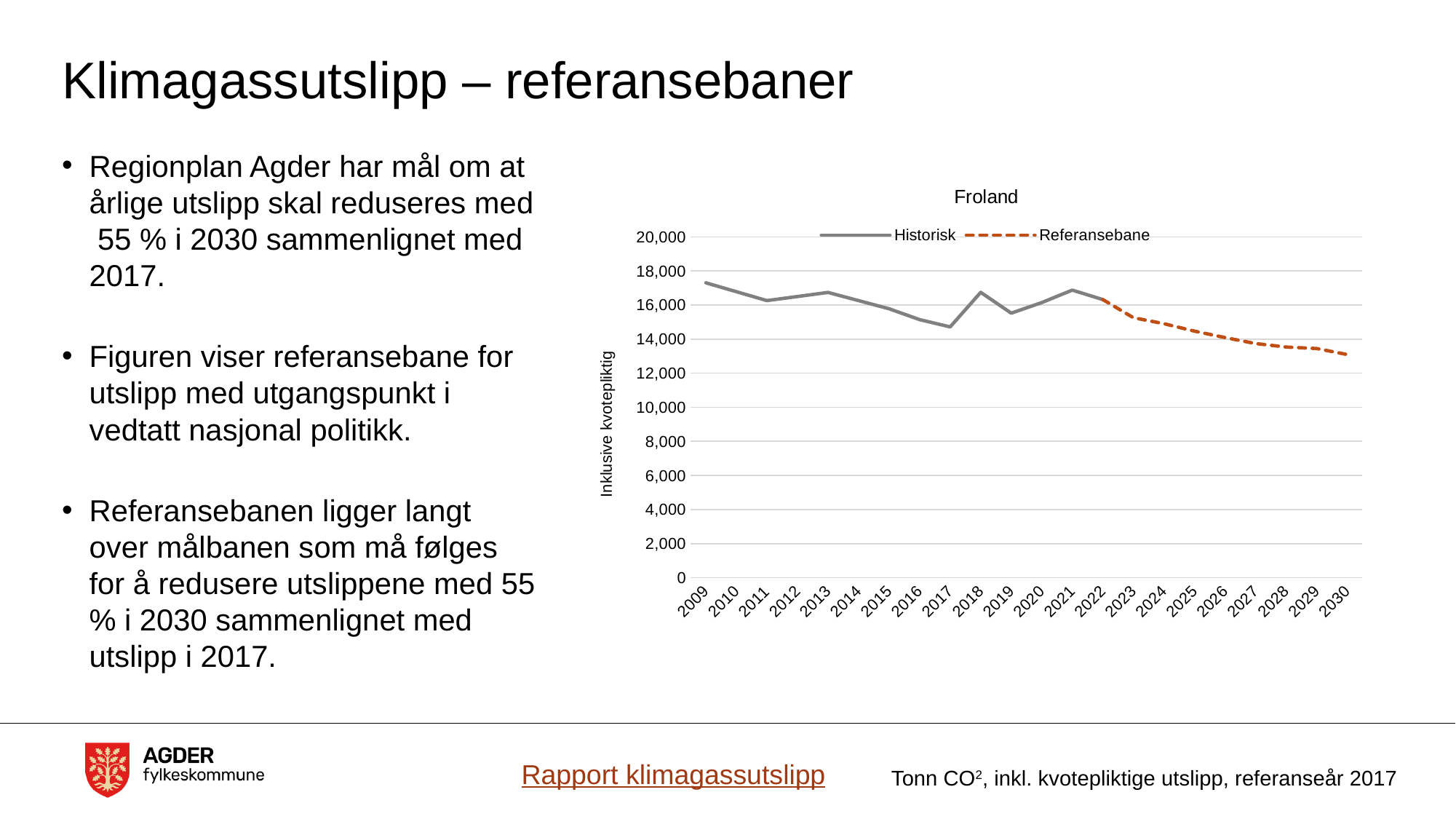
Is the value for 2022 greater or less than 14,000? greater How many series does the chart legend list? 2 What are the two series named in the chart legend? Historisk and Referansebane How many years are shown on the x axis of the chart? 22 Is the Historisk value for 2009 greater or less than 16,000? greater Is the Referansebane value for 2030 greater or less than 14,000? less Does the Referansebane series rise or fall from 2022 to 2030? Fall Which is larger, the Historisk value for 2009 or for 2017? 2009 What is the title of the chart? Froland In which year does the Historisk series reach its lowest value? 2017 What kind of chart is shown on the slide? Line chart